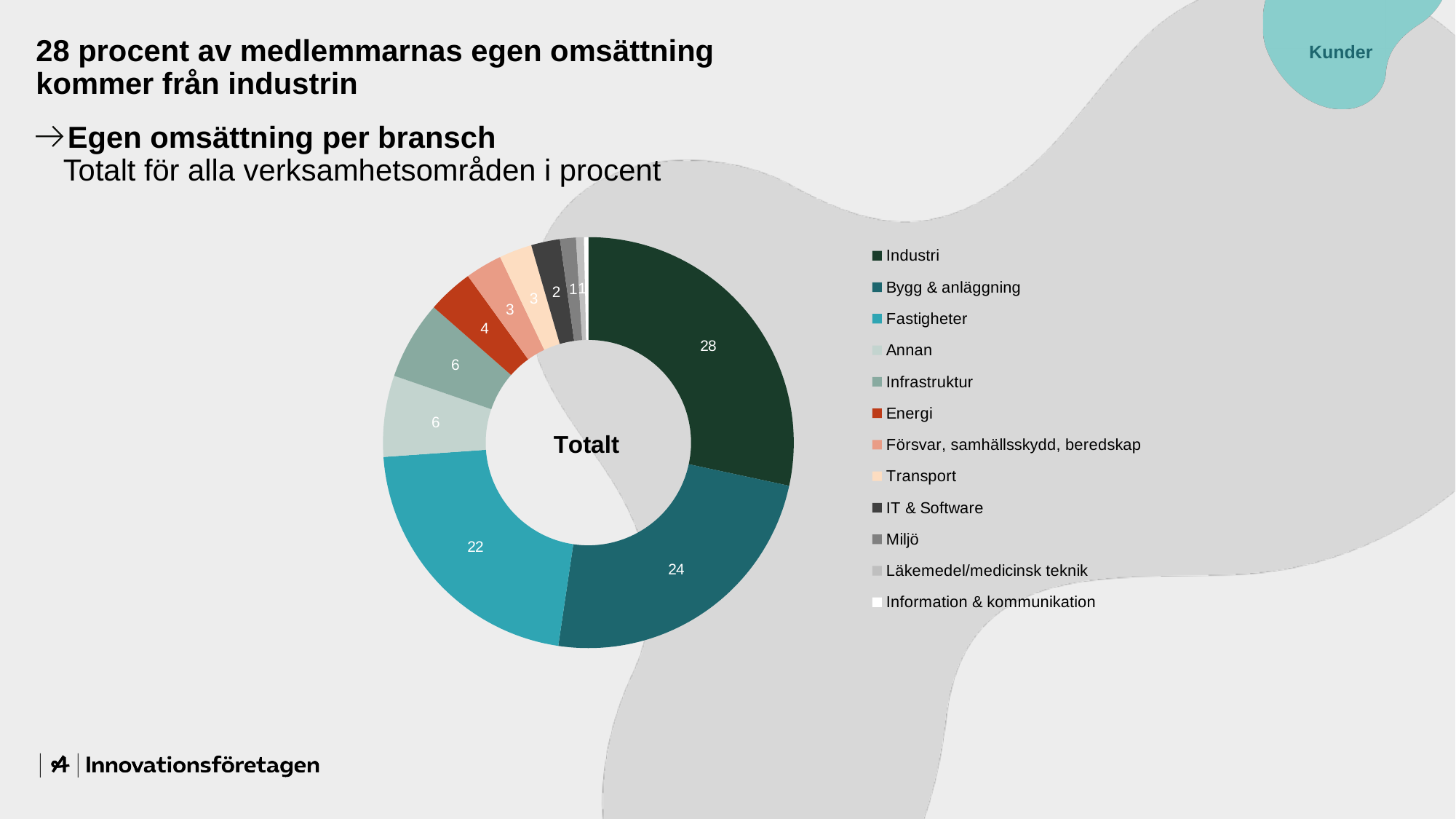
What text is written in the centre of the doughnut chart? Totalt What type of chart is shown on the slide? Doughnut chart Which category has the largest share of the chart? Industri What is the difference between the values for Bygg & anläggning and Infrastruktur? 18 What value is shown for Fastigheter? 22 What value is shown for Industri in the doughnut chart? 28 What value is shown for Energi? 4 What value is shown for IT & Software? 2 What is the difference between the values for Industri and Fastigheter? 6 How many categories does the legend list? 12 What value is shown for Bygg & anläggning? 24 Which is larger, the value for Bygg & anläggning or the value for Fastigheter? Bygg & anläggning